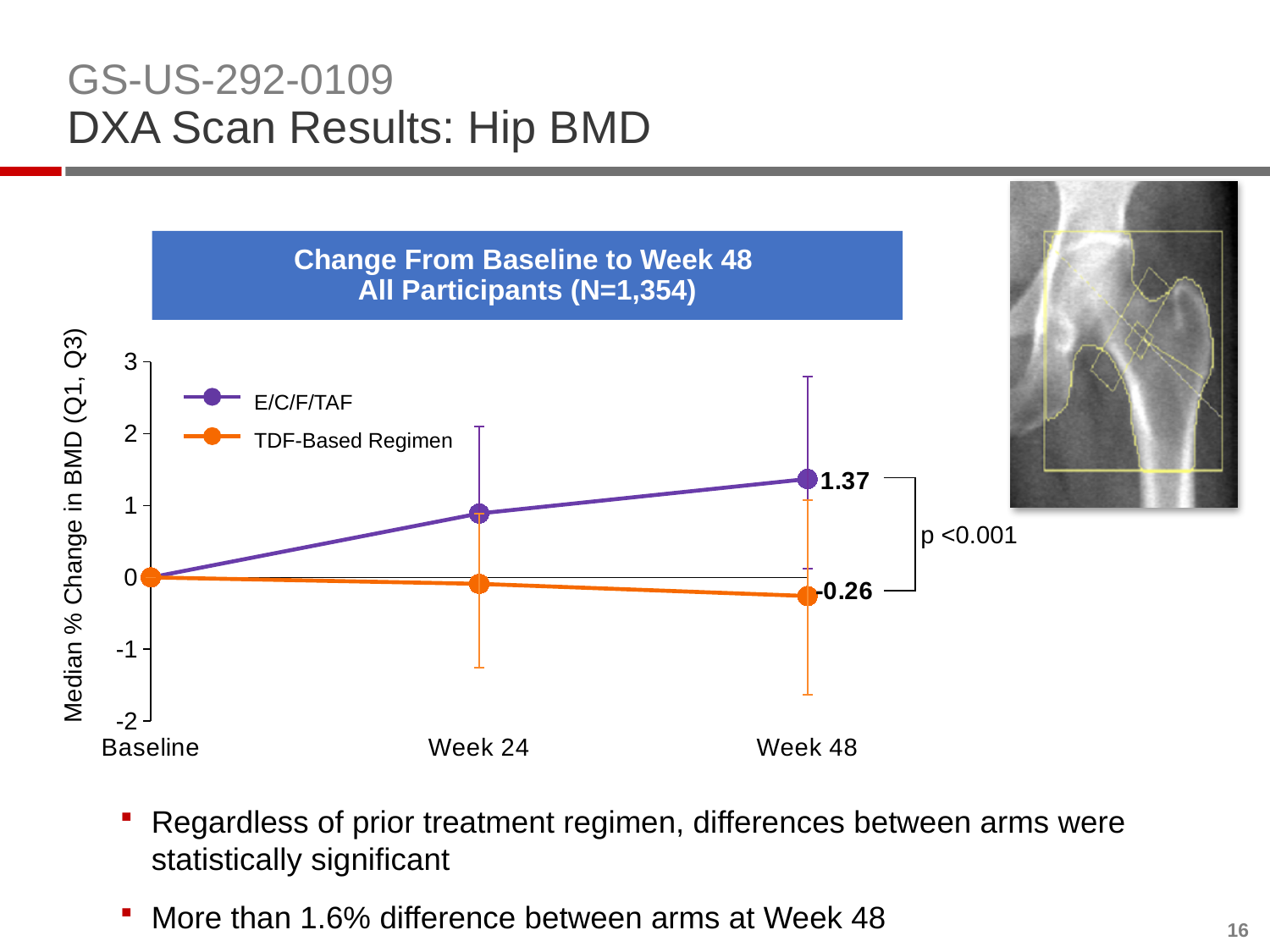
Does the E/C/F/TAF line rise or fall from Baseline to Week 48? rise How many series does the legend list? 2 What is the median % change in hip BMD for E/C/F/TAF at Week 48? 1.37 What p-value is shown for the difference between arms at Week 48? p <0.001 Is the value for E/C/F/TAF at Week 24 greater or less than 2? less What kind of chart is shown on the slide? line chart Is the value for E/C/F/TAF at Week 24 greater or less than 0? greater What is the median % change in hip BMD for the TDF-Based Regimen at Week 48? -0.26 Which series has the higher value at Week 48, E/C/F/TAF or TDF-Based Regimen? E/C/F/TAF Does the TDF-Based Regimen line rise or fall from Baseline to Week 48? fall What is the difference between the E/C/F/TAF and TDF-Based Regimen values at Week 48? 1.63 How many time points are plotted on the x axis? 3